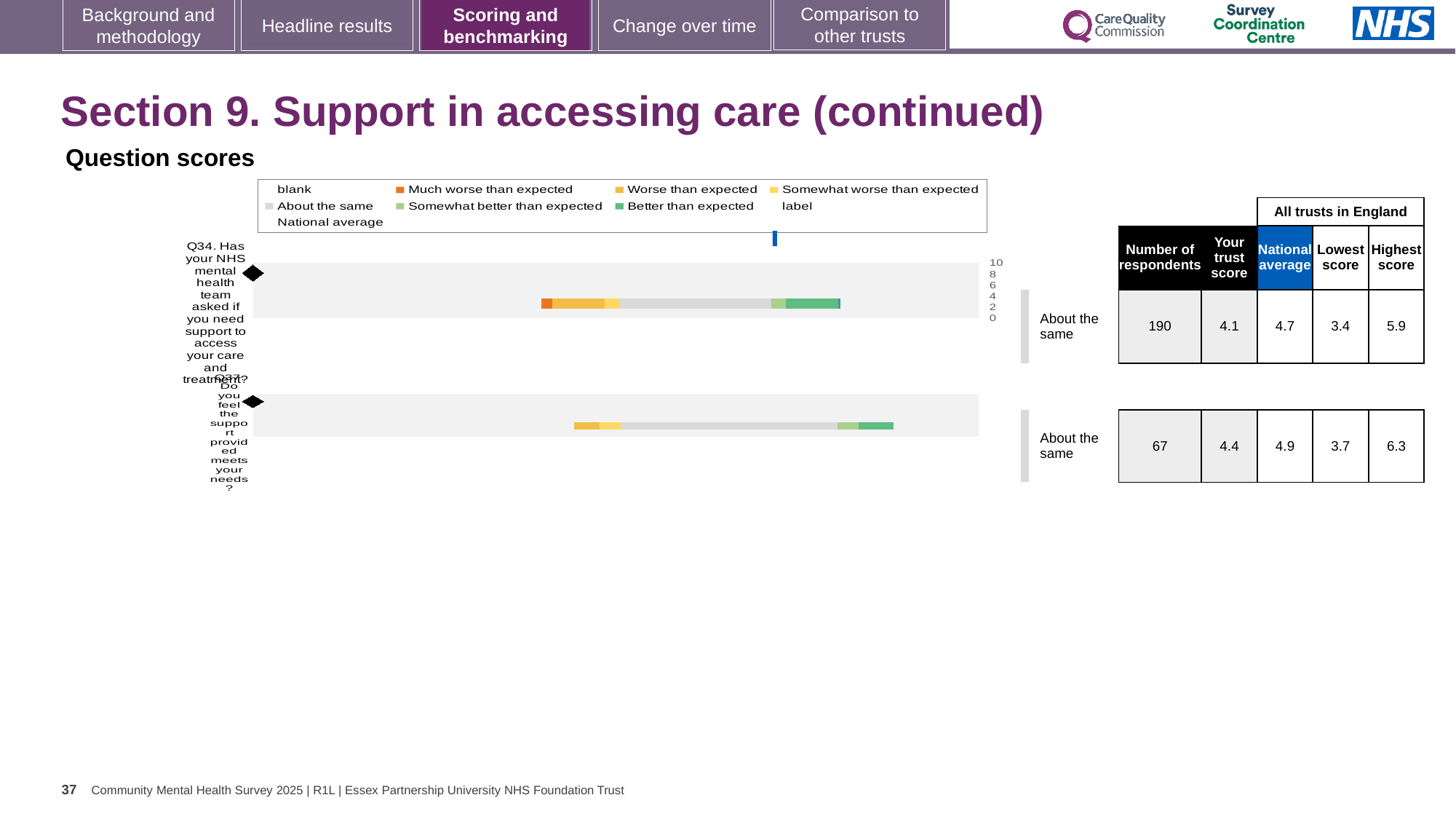
What colour does the legend use for 'Much worse than expected'? orange What is the highest score among all trusts in England for Q37 (Do you feel the support provided meets your needs?)? 6.3 How many respondents answered Q34? 190 What benchmark category is shown next to the bar for Q37? About the same What kind of chart is used to show the question scores on this slide? bar chart What is the lowest score among all trusts in England for Q37? 3.7 What is the national average score for Q34? 4.7 What is the difference between the national average and the trust score for Q34? 0.6 How many questions are plotted in the question scores chart? 2 Which question has the higher 'Your trust score', Q34 or Q37? Q37 What is the 'Your trust score' for Q34 (Has your NHS mental health team asked if you need support to access your care and treatment?)? 4.1 Which question has more respondents, Q34 or Q37? Q34